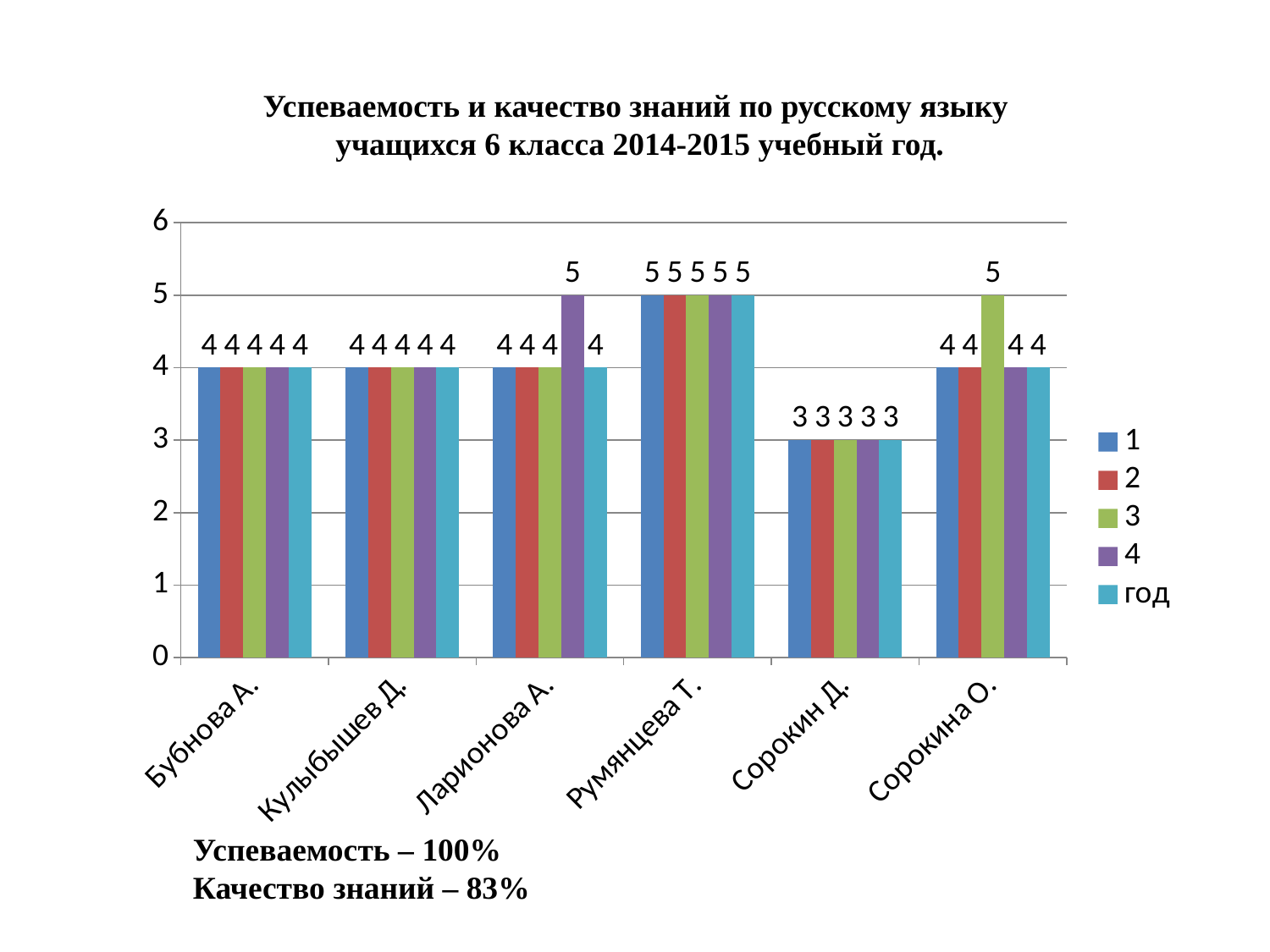
What is the value for Сорокина О. in series 3? 5 What is the value for Румянцева Т. in series 1? 5 What type of chart is shown on the slide? bar chart What is the last entry in the legend? год Which student has the highest value in the series год? Румянцева Т. What is the difference between the год value for Румянцева Т. and the год value for Сорокин Д.? 2 Which is larger: the series 3 value for Сорокина О. or the series 3 value for Бубнова А.? Сорокина О. What is the value for Ларионова А. in series 4? 5 How many series does the legend list? 5 How many students (categories) are shown on the x axis? 6 What is the value for Сорокин Д. in the series год? 3 Which student has the lowest value in the series год? Сорокин Д.